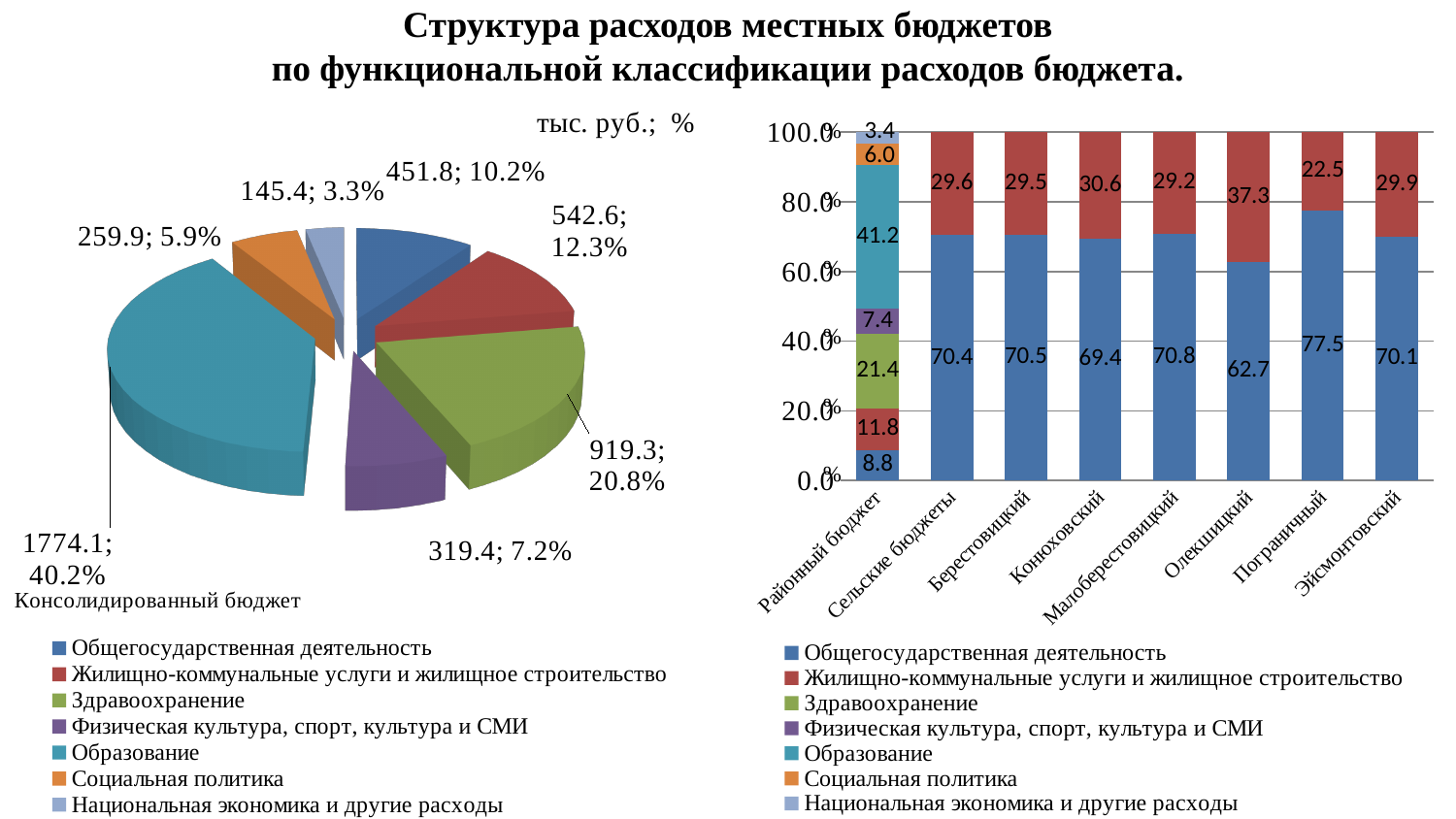
In the pie chart on the left, which category has the largest slice? Образование In the pie chart on the left, what share of the pie does Здравоохранение have? 20.8% In the stacked bar chart on the right, what is the difference between the Общегосударственная деятельность values for Пограничный and Олекшицкий? 14.8 In the stacked bar chart on the right, what is the value of Общегосударственная деятельность for Пограничный? 77.5 In the stacked bar chart on the right, what is the value of Образование for Районный бюджет? 41.2 In the stacked bar chart on the right, which category has the highest value for Жилищно-коммунальные услуги и жилищное строительство? Олекшицкий What type of chart is shown on the right side of the slide? Stacked bar chart In the pie chart on the left, which category has the smallest slice? Национальная экономика и другие расходы In the stacked bar chart on the right, how many series does the legend list? 7 In the stacked bar chart on the right, which category has the lowest value for Общегосударственная деятельность? Районный бюджет In the pie chart on the left, what is the value shown for Образование? 1774.1; 40.2% In the pie chart on the left, how many slices are there? 7